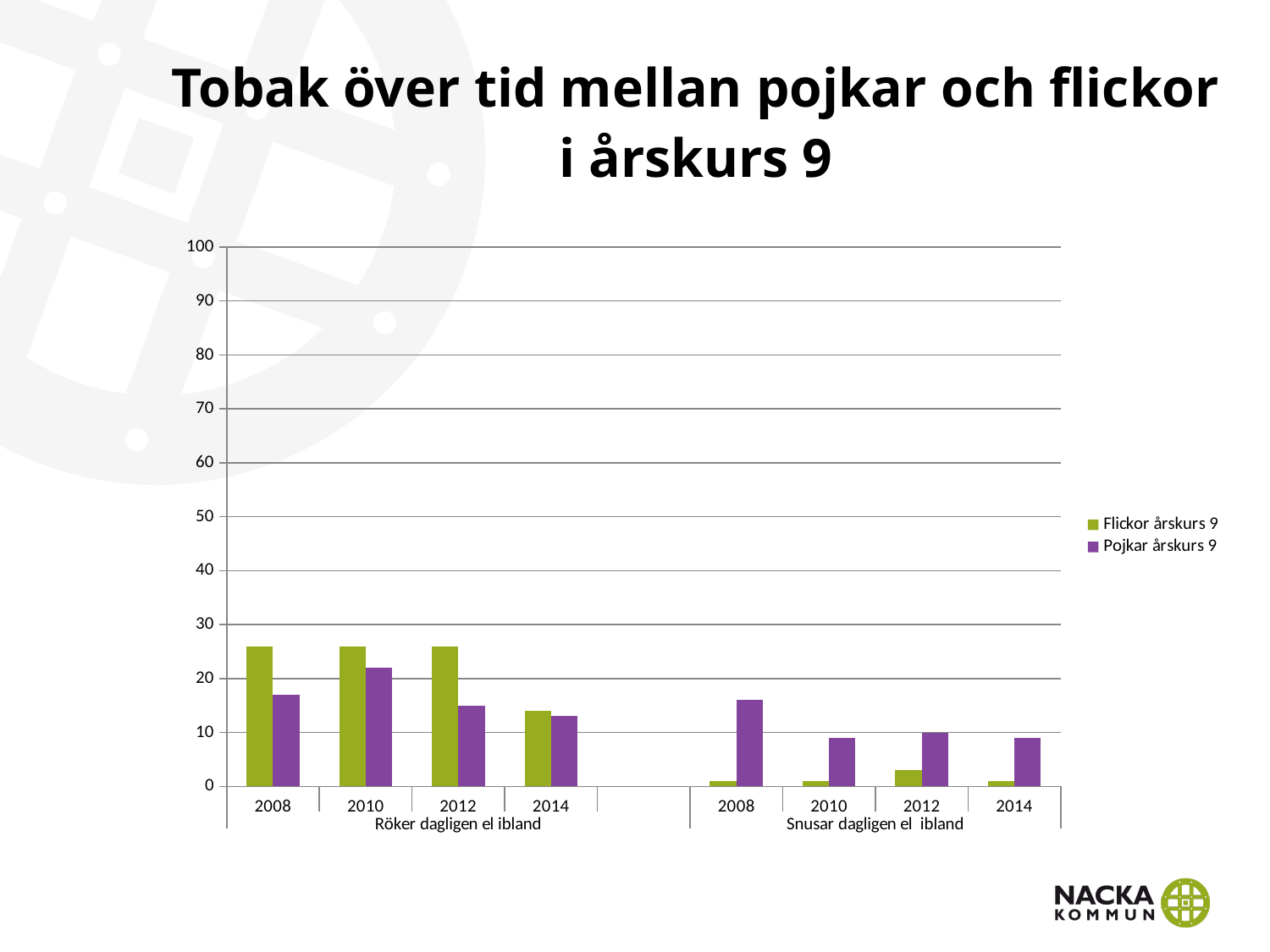
What kind of chart is shown on the slide? bar chart Is the value for Pojkar årskurs 9 in 2008 under "Snusar dagligen el ibland" greater or less than 20? less Is the value for Flickor årskurs 9 in 2008 under "Röker dagligen el ibland" greater or less than 20? greater Is the value for Flickor årskurs 9 in 2012 under "Snusar dagligen el ibland" greater or less than 10? less How many year categories are plotted under "Röker dagligen el ibland"? 4 Which series is shown in green? Flickor årskurs 9 Under "Röker dagligen el ibland" in 2008, which is larger: Flickor årskurs 9 or Pojkar årskurs 9? Flickor årskurs 9 Does the Pojkar årskurs 9 value under "Snusar dagligen el ibland" rise or fall from 2008 to 2014? fall In which year is the Pojkar årskurs 9 bar highest under "Röker dagligen el ibland"? 2010 Under "Snusar dagligen el ibland" in 2008, which is larger: Flickor årskurs 9 or Pojkar årskurs 9? Pojkar årskurs 9 In which year is the Flickor årskurs 9 bar lowest under "Röker dagligen el ibland"? 2014 How many series does the legend list? 2